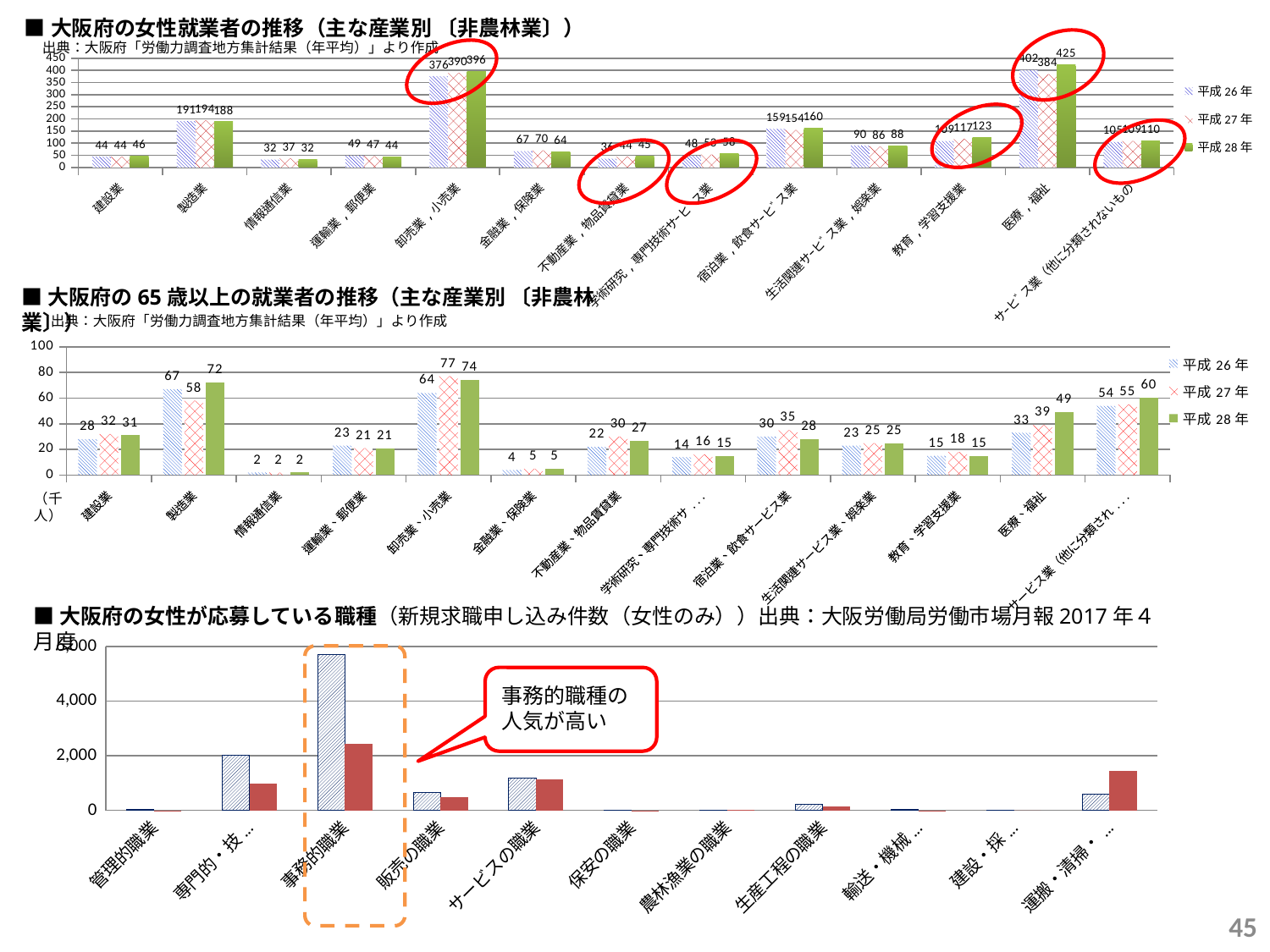
In the middle chart (大阪府の65歳以上の就業者の推移), which is larger in 平成28年: 卸売業、小売業 or 医療、福祉? 卸売業、小売業 In the middle chart (大阪府の65歳以上の就業者の推移), what is the value for 製造業 in 平成27年? 58 In the top chart (大阪府の女性就業者の推移), how many series does the legend list? 3 In the middle chart (大阪府の65歳以上の就業者の推移), how many industry categories are shown? 13 In the top chart (大阪府の女性就業者の推移), do the values for 教育，学習支援業 rise or fall from 平成26年 to 平成28年? rise In the top chart (大阪府の女性就業者の推移), what is the difference between the 平成28年 and 平成26年 values for 医療，福祉? 23 In the middle chart (大阪府の65歳以上の就業者の推移), what is the difference between the 平成27年 and 平成26年 values for 卸売業、小売業? 13 In the bottom chart (大阪府の女性が応募している職種), is the value of the blue hatched bar for 事務的職業 greater or less than 4,000? greater What kind of chart is the bottom chart (大阪府の女性が応募している職種)? bar chart In the top chart (大阪府の女性就業者の推移), what is the value for 卸売業，小売業 in 平成28年? 396 In the middle chart (大阪府の65歳以上の就業者の推移), which industry has the lowest value in 平成28年? 情報通信業 In the top chart (大阪府の女性就業者の推移), which industry has the highest value in 平成28年? 医療，福祉